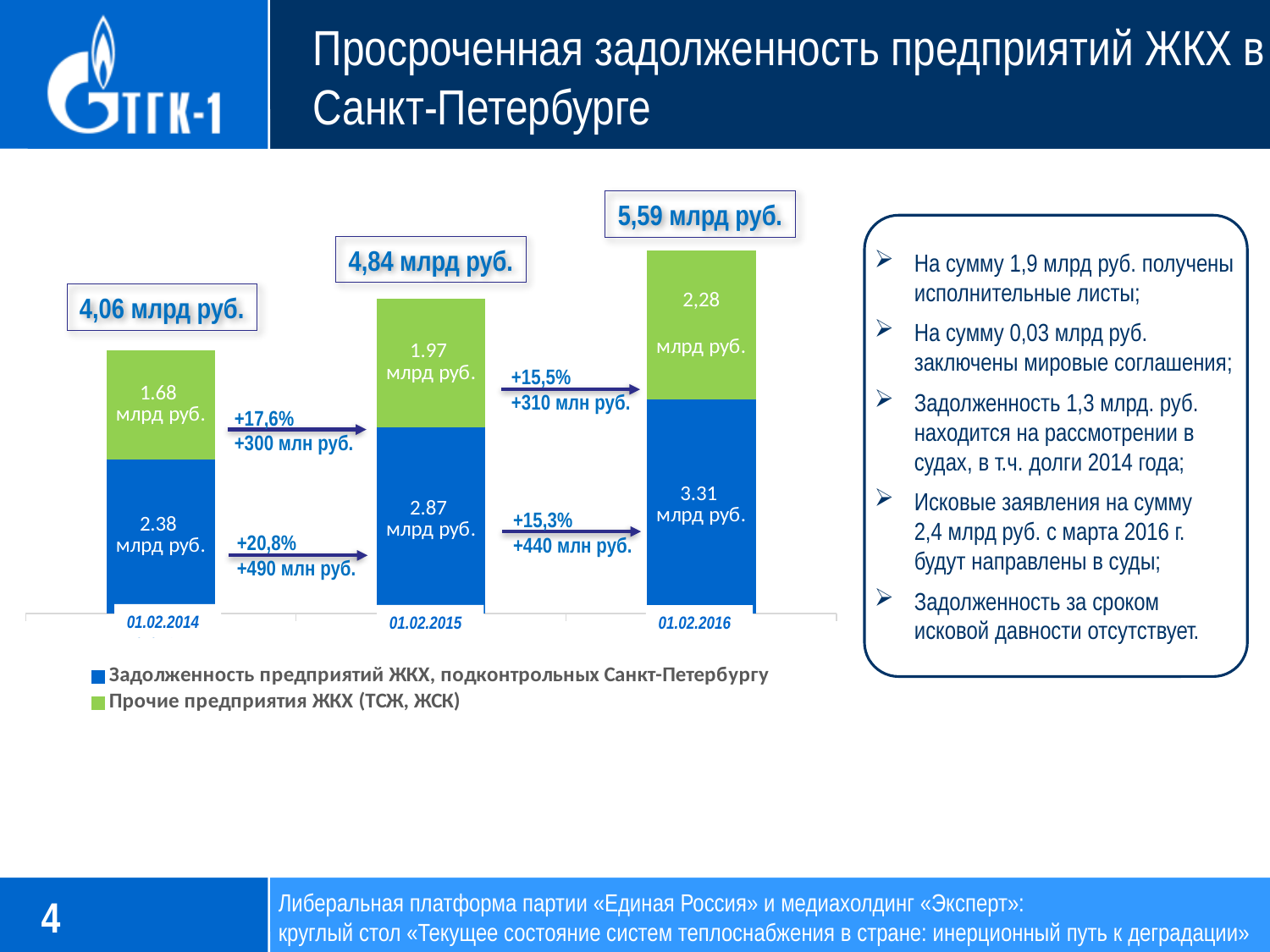
What is the total of the stacked bar for 01.02.2014? 4,06 млрд руб. Do the total debt values rise or fall from 01.02.2014 to 01.02.2016? rise What is the value of the green series (Прочие предприятия ЖКХ (ТСЖ, ЖСК)) for 01.02.2015? 1.97 млрд руб. On which date is the green series (Прочие предприятия ЖКХ) value the lowest? 01.02.2014 On which date is the total debt the highest? 01.02.2016 What is the total of the stacked bar for 01.02.2016? 5,59 млрд руб. What is the difference between the blue series values for 01.02.2016 and 01.02.2015? 0.44 млрд руб. What kind of chart is shown on the slide? stacked bar chart How many series does the chart legend list? 2 How many dates (categories) are shown on the x axis of the chart? 3 What is the value of the blue series for 01.02.2016? 3.31 млрд руб. What is the value of the blue series (Задолженность предприятий ЖКХ, подконтрольных Санкт-Петербургу) for 01.02.2014? 2.38 млрд руб.